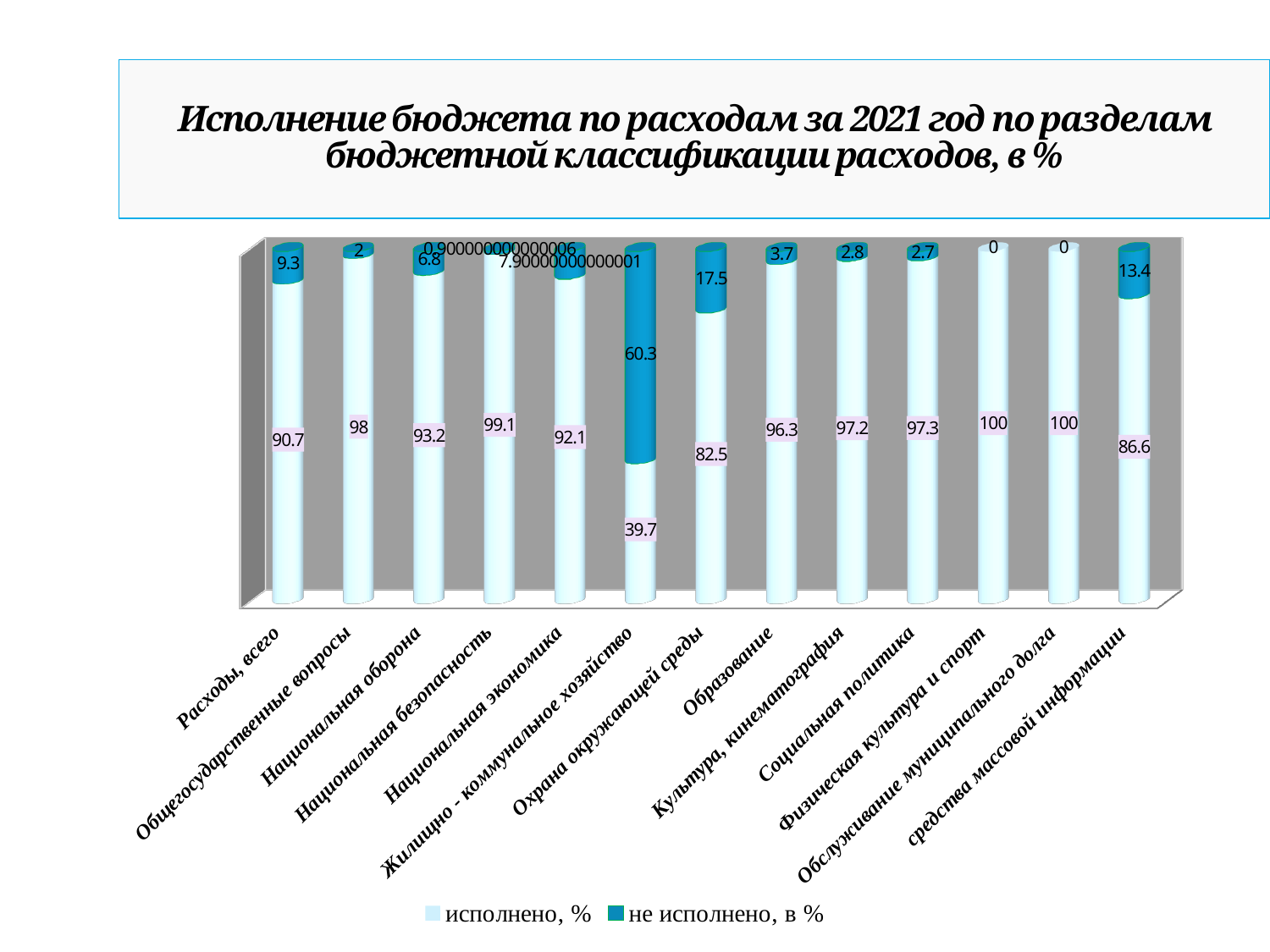
Which category has the lowest value of "исполнено, %"? Жилищно - коммунальное хозяйство What is the value of "не исполнено, в %" for Охрана окружающей среды? 17.5 What is the difference between the "исполнено, %" values for Образование and Охрана окружающей среды? 13.8 What kind of chart is shown on the slide? Stacked bar chart What is the value of "не исполнено, в %" for средства массовой информации? 13.4 What is the total of the stacked bar for Расходы, всего? 100 How many categories are shown on the x axis? 13 What is the value of "исполнено, %" for Жилищно - коммунальное хозяйство? 39.7 What is the value of "исполнено, %" for Образование? 96.3 Which category has the highest value of "не исполнено, в %"? Жилищно - коммунальное хозяйство How many series does the legend list? 2 Which has a larger "исполнено, %" value: Национальная оборона or Национальная безопасность? Национальная безопасность